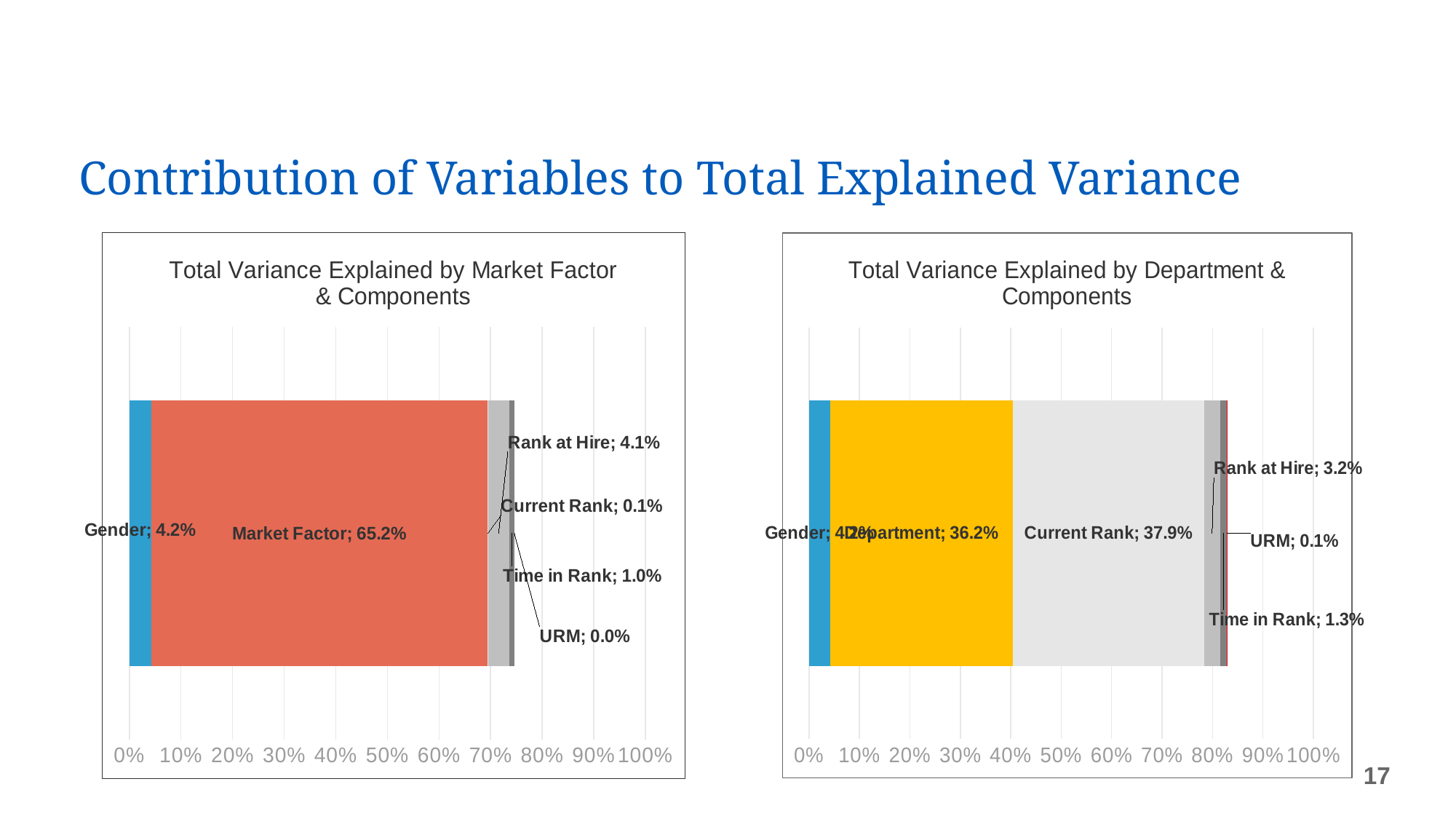
What kind of chart is the chart titled 'Total Variance Explained by Department & Components'? Stacked bar chart In the chart titled 'Total Variance Explained by Market Factor & Components', what is the value for Rank at Hire? 4.1% In the chart titled 'Total Variance Explained by Market Factor & Components', what is the total of all the stacked segments? 74.6% In the chart titled 'Total Variance Explained by Department & Components', what is the difference between Rank at Hire and Time in Rank? 1.9% In the chart titled 'Total Variance Explained by Department & Components', what is the value for Department? 36.2% In the chart titled 'Total Variance Explained by Department & Components', what is the value for Current Rank? 37.9% In the chart titled 'Total Variance Explained by Department & Components', which is larger, Department or Current Rank? Current Rank In the chart titled 'Total Variance Explained by Department & Components', what is the value for Time in Rank? 1.3% In the chart titled 'Total Variance Explained by Market Factor & Components', what is the value for Market Factor? 65.2% In the chart titled 'Total Variance Explained by Market Factor & Components', which component has the largest value? Market Factor In the chart titled 'Total Variance Explained by Market Factor & Components', what is the difference between Market Factor and Gender? 61.0% In the chart titled 'Total Variance Explained by Market Factor & Components', which component has the smallest value? URM